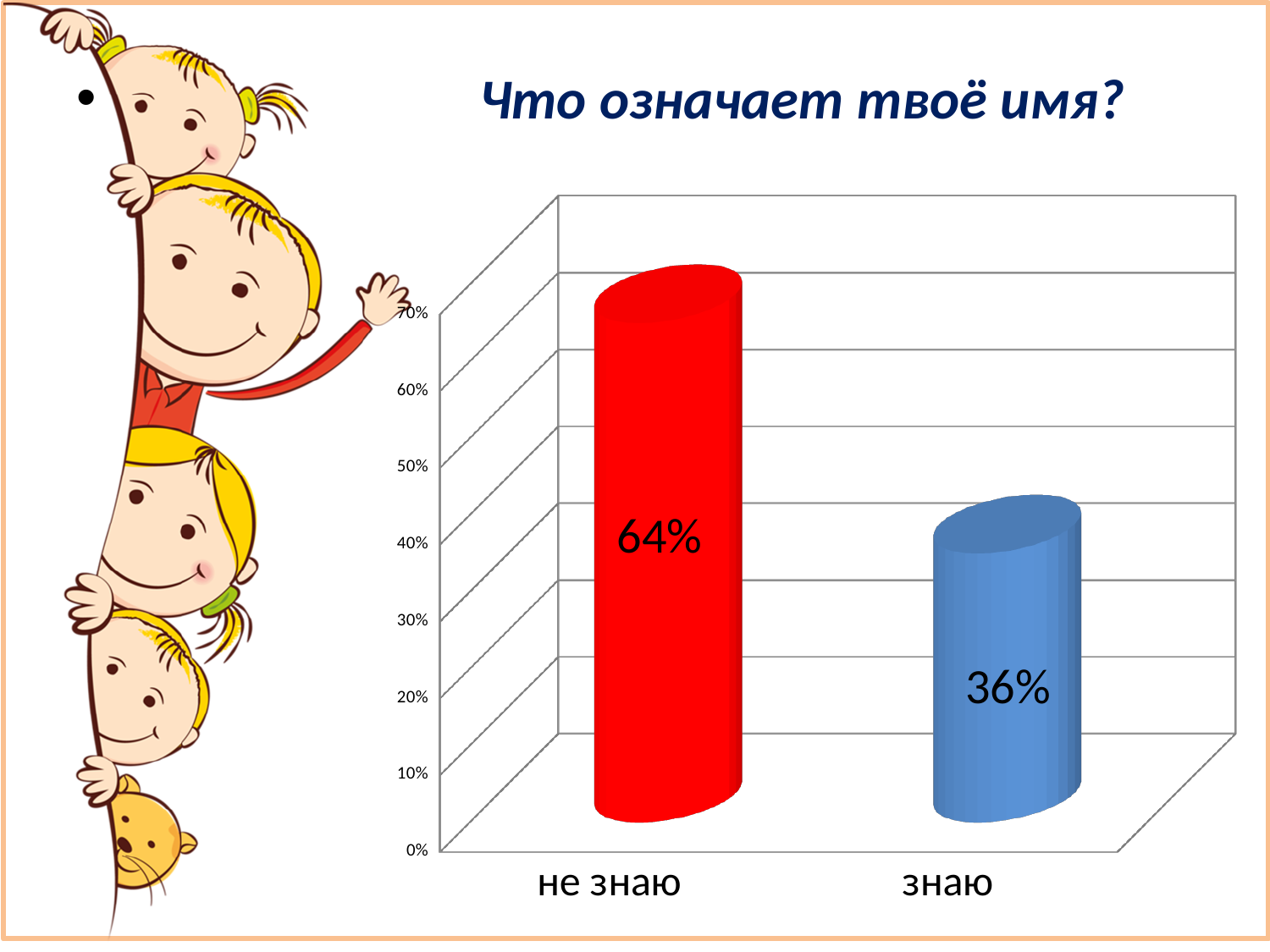
Is the value for "знаю" greater or less than 50%? less What colour is the bar for "знаю"? blue What is the value for "не знаю"? 64% Which is larger, the value for "не знаю" or the value for "знаю"? не знаю What is the title of the slide above the chart? Что означает твоё имя? What kind of chart is shown on the slide? bar chart Which category has the highest value? не знаю What is the value for "знаю"? 36% How many categories are shown on the chart? 2 Is the value for "не знаю" greater or less than 60%? greater What is the difference between the values for "не знаю" and "знаю"? 28% Which category has the lowest value? знаю